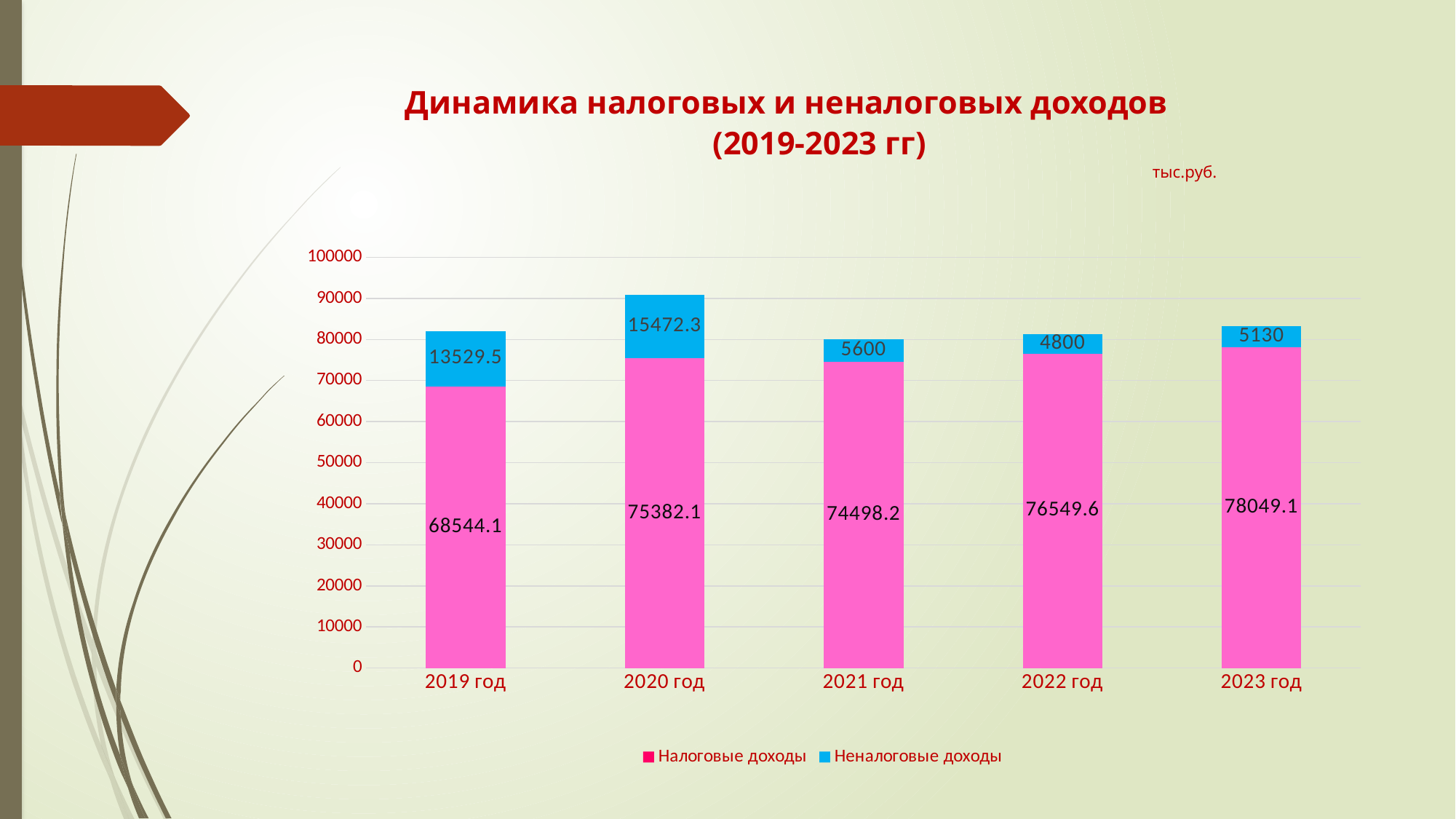
What is the value of Неналоговые доходы for 2022 год? 4800 How many years are shown on the x axis? 5 What is the value of Неналоговые доходы for 2020 год? 15472.3 What is the value of Налоговые доходы for 2019 год? 68544.1 What is the difference between Налоговые доходы in 2023 год and 2019 год? 9505 What is the total of the stacked bar for 2020 год? 90854.4 What kind of chart is shown on the slide? Stacked bar chart Which year has the lowest value of Неналоговые доходы? 2022 год Which year has the highest value of Налоговые доходы? 2023 год What unit is indicated for the values on the chart? тыс.руб. How many series does the legend list? 2 Which is larger: Неналоговые доходы in 2021 год or in 2023 год? 2021 год